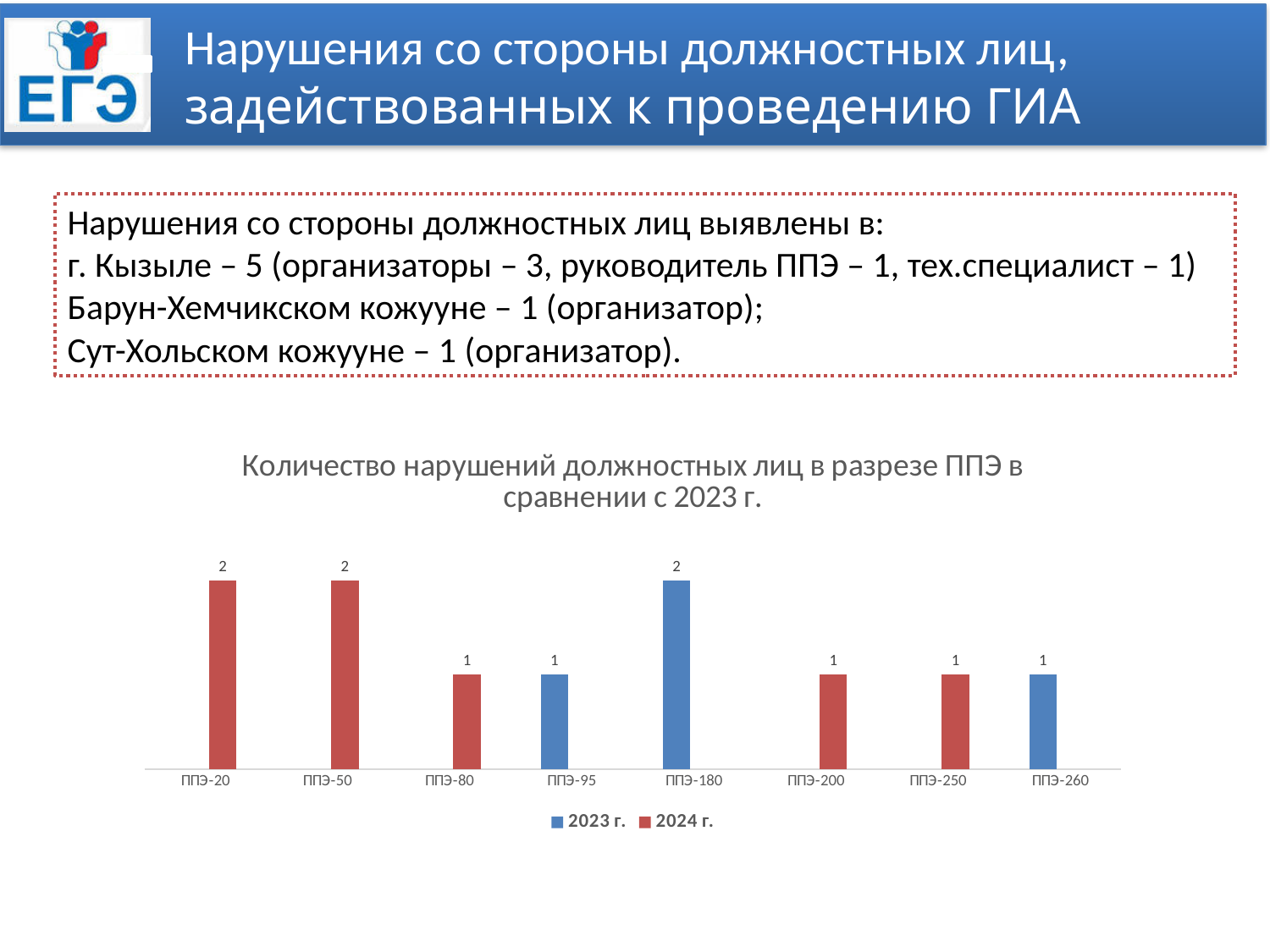
How many series does the chart legend list? 2 What is the value for ППЭ-260 in 2023 г.? 1 How many ППЭ categories are shown on the x axis of the chart? 8 What is the value for ППЭ-80 in 2024 г.? 1 Which is larger: the value for ППЭ-180 in 2023 г. or the value for ППЭ-95 in 2023 г.? ППЭ-180 What is the value for ППЭ-180 in 2023 г.? 2 What is the difference between the value for ППЭ-50 in 2024 г. and the value for ППЭ-200 in 2024 г.? 1 Which ППЭ categories have a value of 2 in 2024 г.? ППЭ-20 and ППЭ-50 Which series is shown in red in the chart? 2024 г. What is the title of the chart? Количество нарушений должностных лиц в разрезе ППЭ в сравнении с 2023 г. What type of chart is shown on the slide? bar chart What is the value for ППЭ-20 in 2024 г.? 2